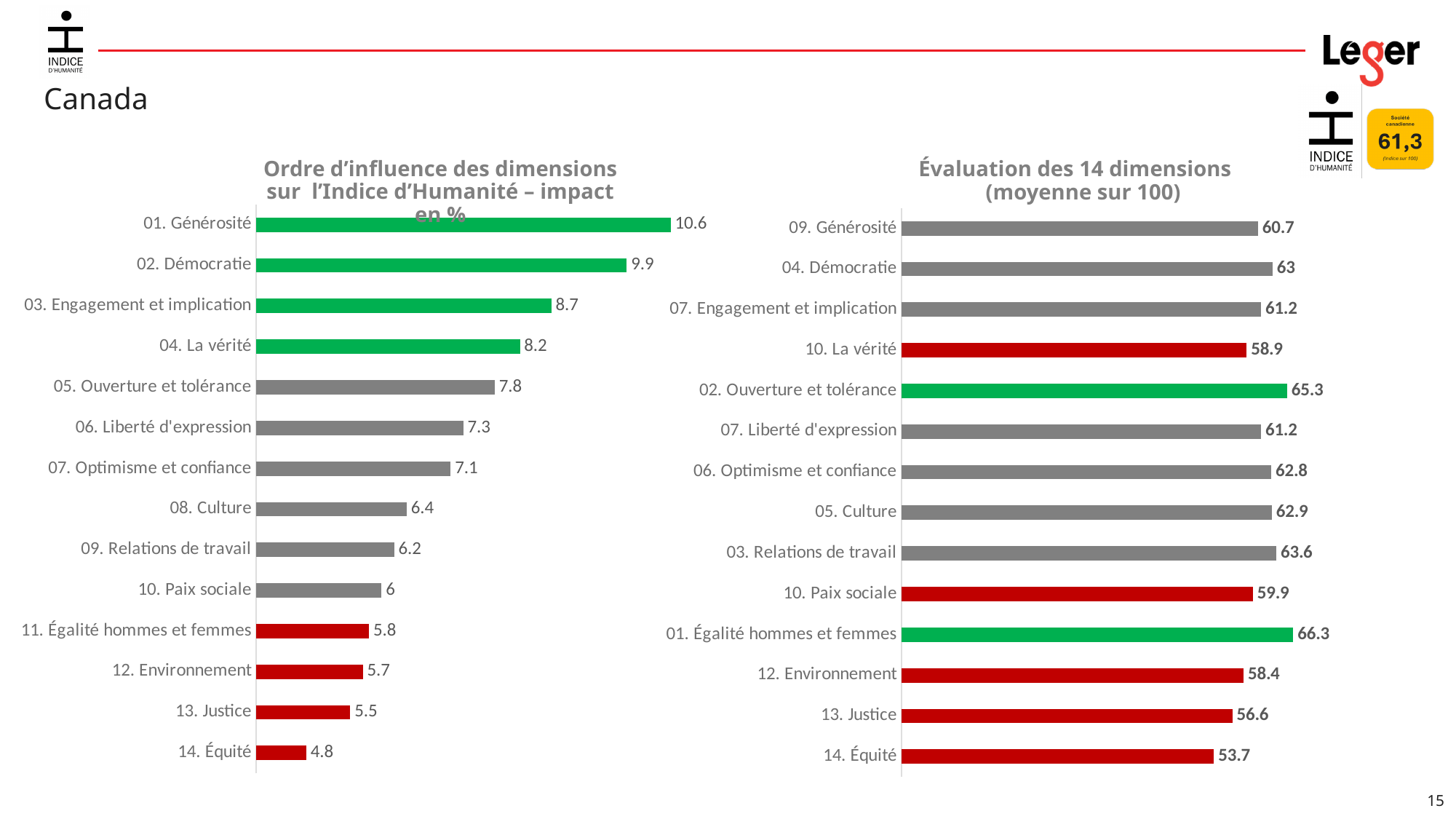
In the right chart (Évaluation des 14 dimensions), which dimension has the lowest value? 14. Équité In the right chart (Évaluation des 14 dimensions), what is the difference between the values for 02. Ouverture et tolérance and 10. La vérité? 6.4 In the right chart (Évaluation des 14 dimensions), which dimension has the highest value? 01. Égalité hommes et femmes In the left chart (Ordre d'influence des dimensions), which dimension has the lowest value? 14. Équité In the left chart (Ordre d'influence des dimensions), which is larger: the value for 08. Culture or the value for 10. Paix sociale? 08. Culture In the right chart (Évaluation des 14 dimensions), what colour are the bars for 12. Environnement, 13. Justice and 14. Équité? Red What kind of chart is the right chart (Évaluation des 14 dimensions)? Bar chart How many dimensions are plotted in the left chart (Ordre d'influence des dimensions)? 14 In the right chart (Évaluation des 14 dimensions), which is larger: the value for 03. Relations de travail or the value for 04. Démocratie? 03. Relations de travail In the left chart (Ordre d'influence des dimensions), what is the difference between the values for 02. Démocratie and 03. Engagement et implication? 1.2 In the right chart (Évaluation des 14 dimensions), what is the value for 13. Justice? 56.6 In the left chart (Ordre d'influence des dimensions), what is the value for 01. Générosité? 10.6